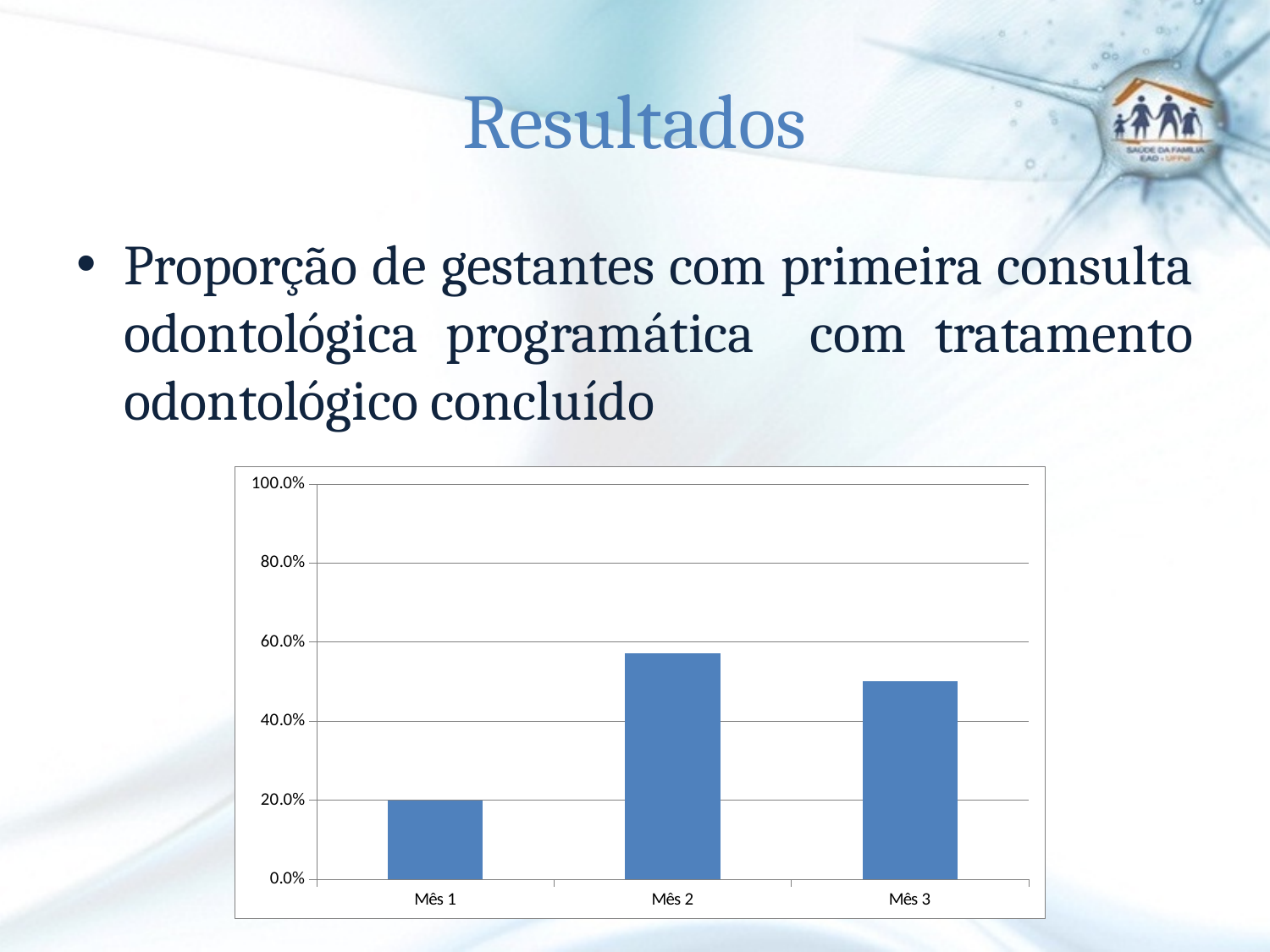
Is the value for Mês 2 greater or less than 40.0%? greater Does the value rise or fall from Mês 2 to Mês 3? fall Is the value for Mês 1 greater or less than 40.0%? less Which has a larger value, Mês 2 or Mês 3? Mês 2 Which month has the lowest value in the chart? Mês 1 Which month has the highest value in the chart? Mês 2 Which has a larger value, Mês 1 or Mês 3? Mês 3 What kind of chart is shown on the slide? bar chart How many categories are shown on the x axis of the chart? 3 Is the value for Mês 3 greater or less than 40.0%? greater What is the highest value shown on the chart's y axis? 100.0%